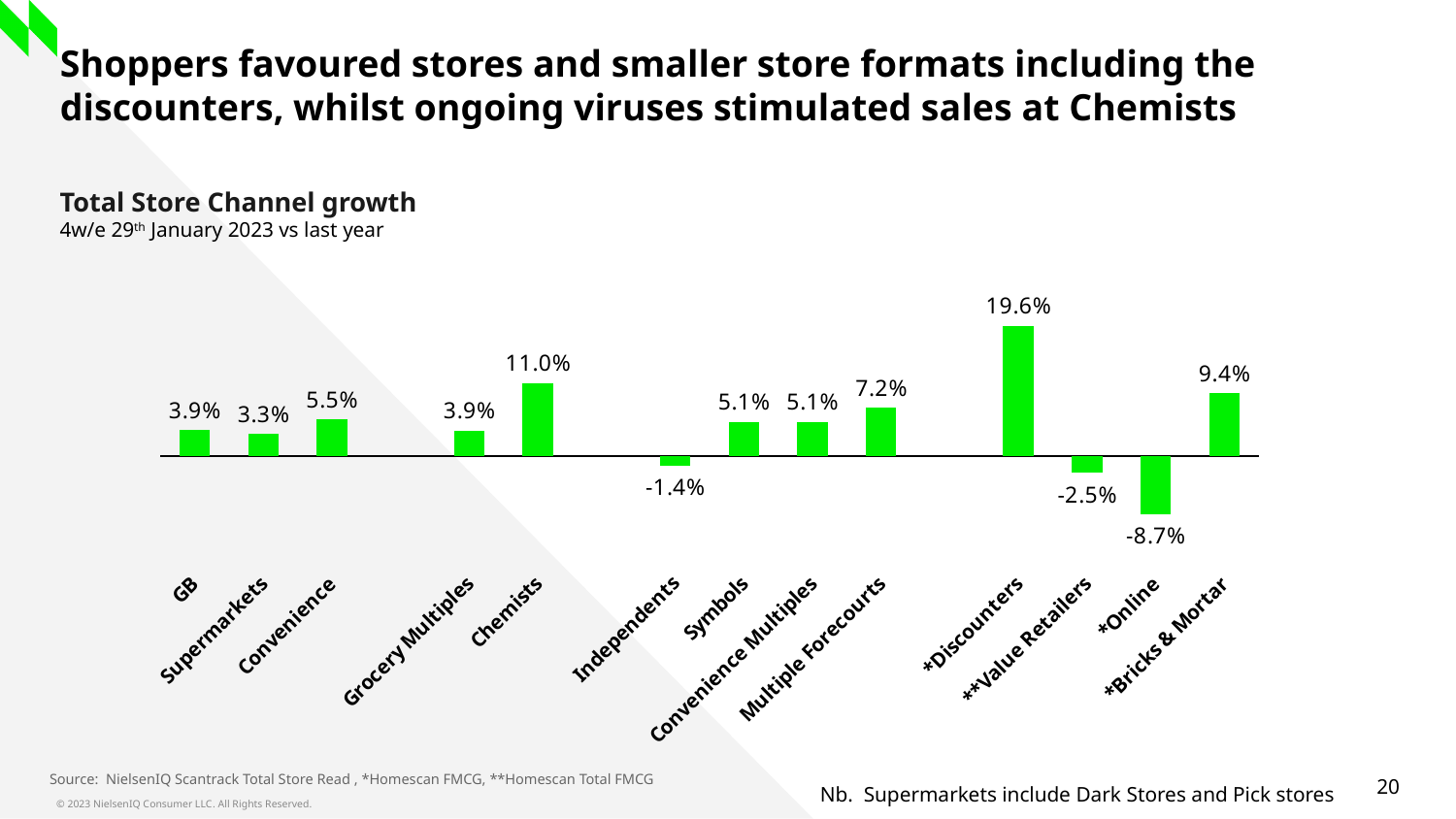
What is the growth value for Chemists? 11.0% What kind of chart is shown on the slide? Bar chart What is the title of the chart? Total Store Channel growth Which category has the highest growth? Discounters How many categories are shown in the chart? 13 What is the difference between the growth for Independents and the growth for Value Retailers? 1.1% What is the growth value for Supermarkets? 3.3% Which category has the lowest growth? Online What is the growth value for Bricks & Mortar? 9.4% What is the difference between the growth for Discounters and the growth for Chemists? 8.6% Which is larger, the growth for Convenience or the growth for Multiple Forecourts? Multiple Forecourts What is the growth value for Online? -8.7%